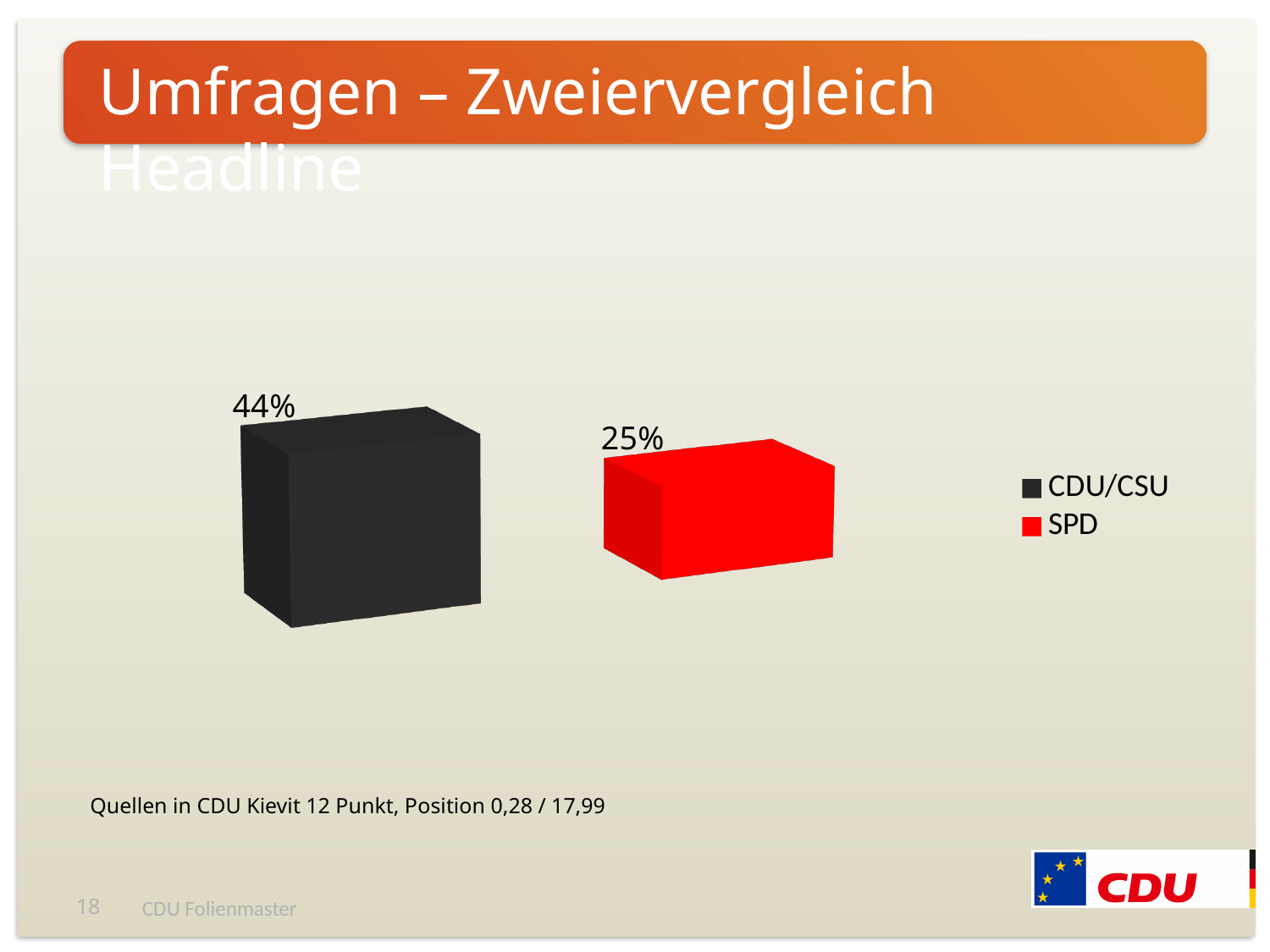
What kind of chart is shown on the slide? Bar chart Which is larger, the value for CDU/CSU or the value for SPD? CDU/CSU Which series has the highest value? CDU/CSU What is the value for SPD? 25% Which series has the lowest value? SPD What is the value for CDU/CSU? 44% What colour is the bar for SPD? Red How many bars are plotted in the chart? 2 How many series does the legend list? 2 What colour is the bar for CDU/CSU? Black What is the difference between the CDU/CSU value and the SPD value? 19%